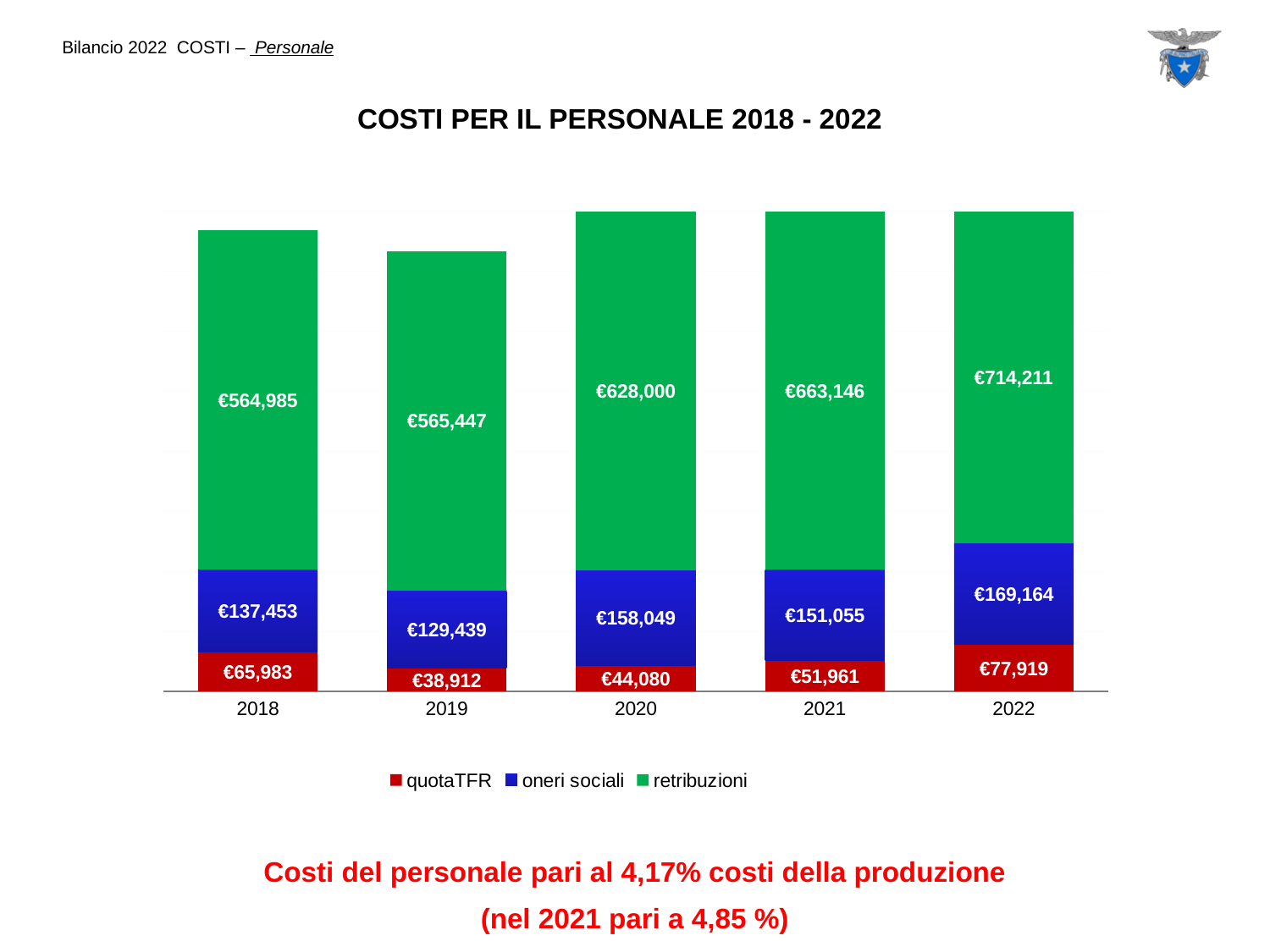
In which year is retribuzioni highest? 2022 How many series does the legend list? 3 What is the total of the stacked bar for 2022? €961,294 What is the difference between retribuzioni in 2022 and in 2021? €51,065 In which year is oneri sociali lowest? 2019 What is the value of oneri sociali for 2018? €137,453 In which year is quotaTFR lowest? 2019 What is the value of retribuzioni for 2020? €628,000 What kind of chart is shown? Stacked bar chart What is the quotaTFR value for 2021? €51,961 Which is larger, oneri sociali in 2020 or oneri sociali in 2021? 2020 What is the difference between quotaTFR in 2022 and in 2019? €39,007